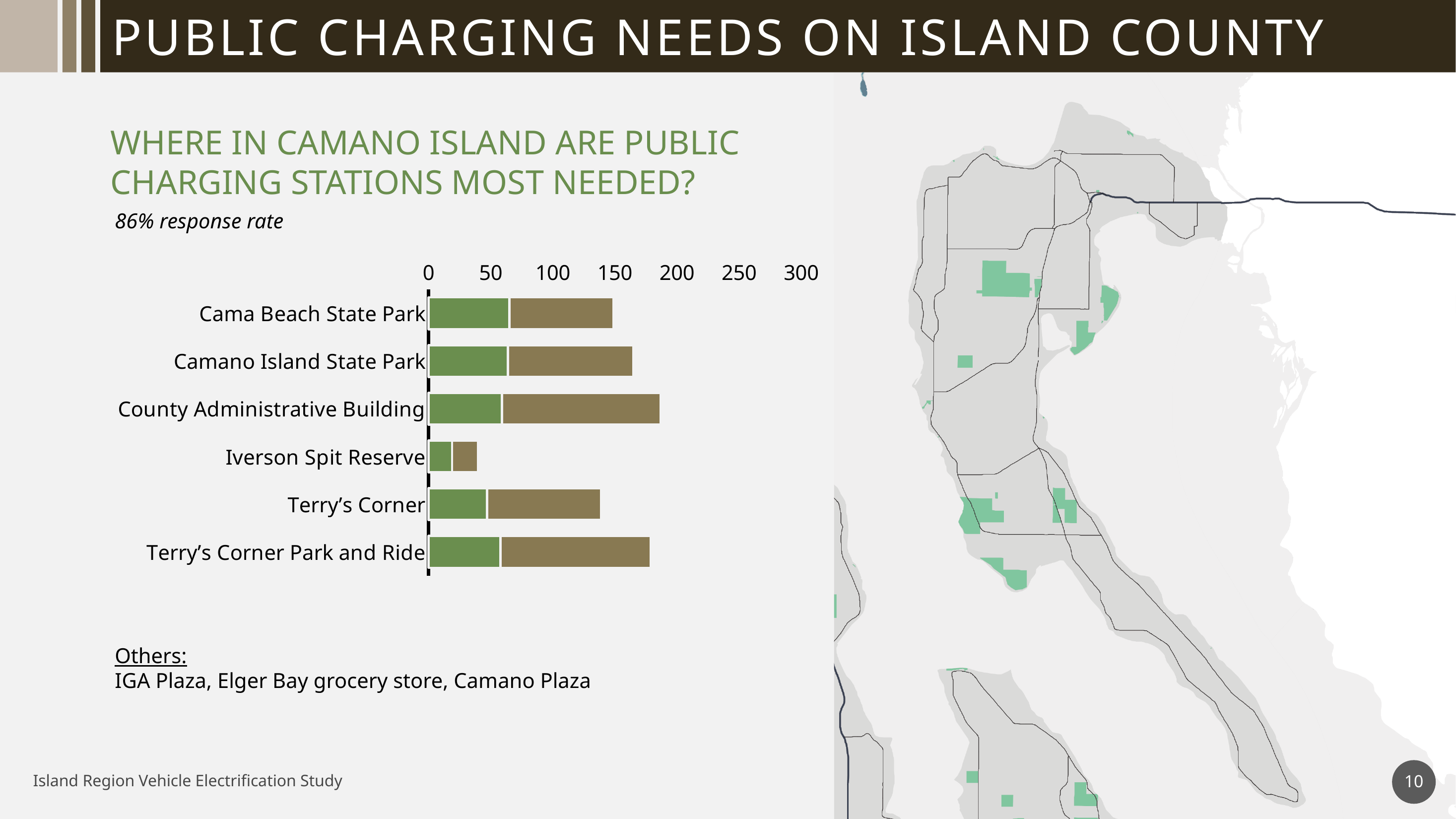
Is the total value for Terry's Corner greater or less than 100? greater Is the total value for Terry's Corner Park and Ride greater or less than 150? greater Which has the larger total bar, Camano Island State Park or Cama Beach State Park? Camano Island State Park Which has the larger total bar, County Administrative Building or Terry's Corner? County Administrative Building How many locations are listed on the chart? 6 What kind of chart is shown on the slide? bar chart Is the total value for Cama Beach State Park greater or less than 100? greater What response rate is stated above the chart? 86% response rate Which location has the lowest total bar on the chart? Iverson Spit Reserve